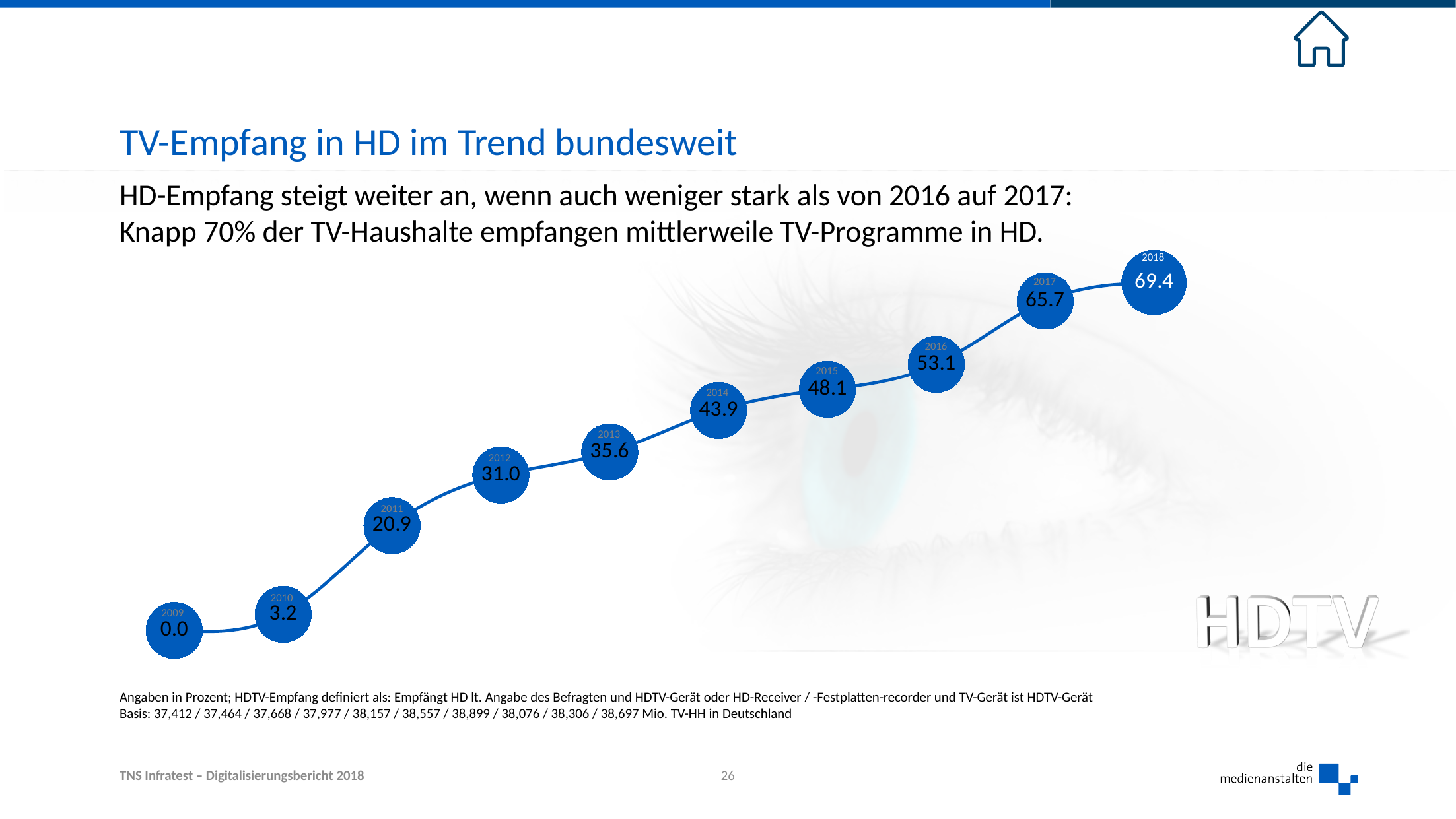
Which is larger, the value for 2014 or the value for 2015? 2015 What is the difference between the values for 2018 and 2017? 3.7 Which year has the highest value? 2018 What is the title of the slide containing the chart? TV-Empfang in HD im Trend bundesweit How many data points are plotted on the chart? 10 What is the value for 2018? 69.4 Do the values rise or fall from 2009 to 2018? rise What is the value for 2010? 3.2 Which year has the lowest value? 2009 What is the difference between the values for 2017 and 2016? 12.6 What is the value for 2013? 35.6 What kind of chart is shown on the slide? line chart